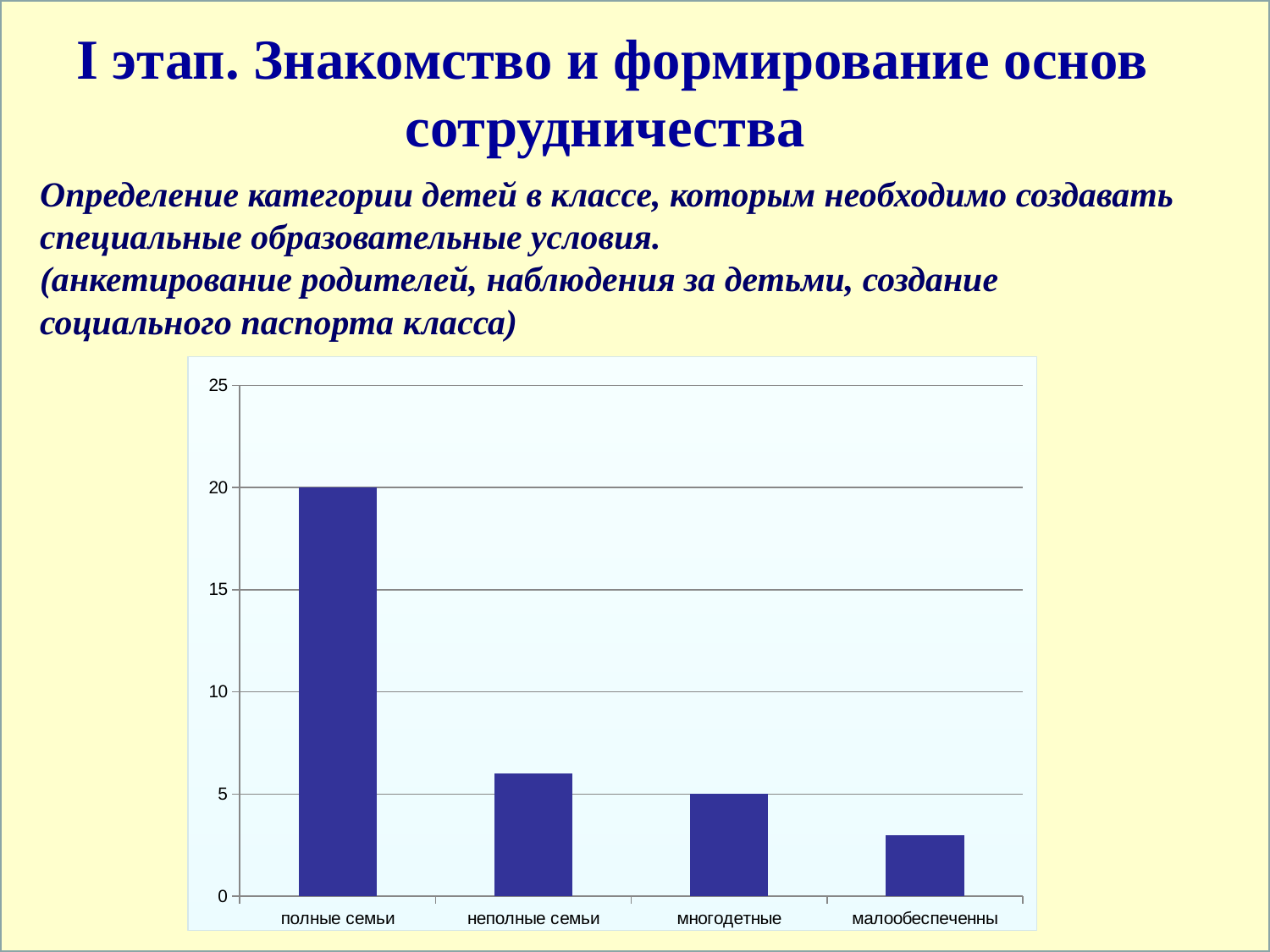
Do the values rise or fall from left to right along the x axis? fall What is the value for полные семьи? 20 What is the difference between the values for полные семьи and многодетные? 15 Is the value for неполные семьи greater or less than 10? less How many categories are shown on the x axis? 4 Is the value for малообеспеченны greater or less than 5? less Which category has the lowest value? малообеспеченны Which is larger, the value for полные семьи or the value for неполные семьи? полные семьи What kind of chart is shown on the slide? bar chart What is the highest value shown on the vertical axis? 25 Which category has the highest value? полные семьи What is the value for многодетные? 5